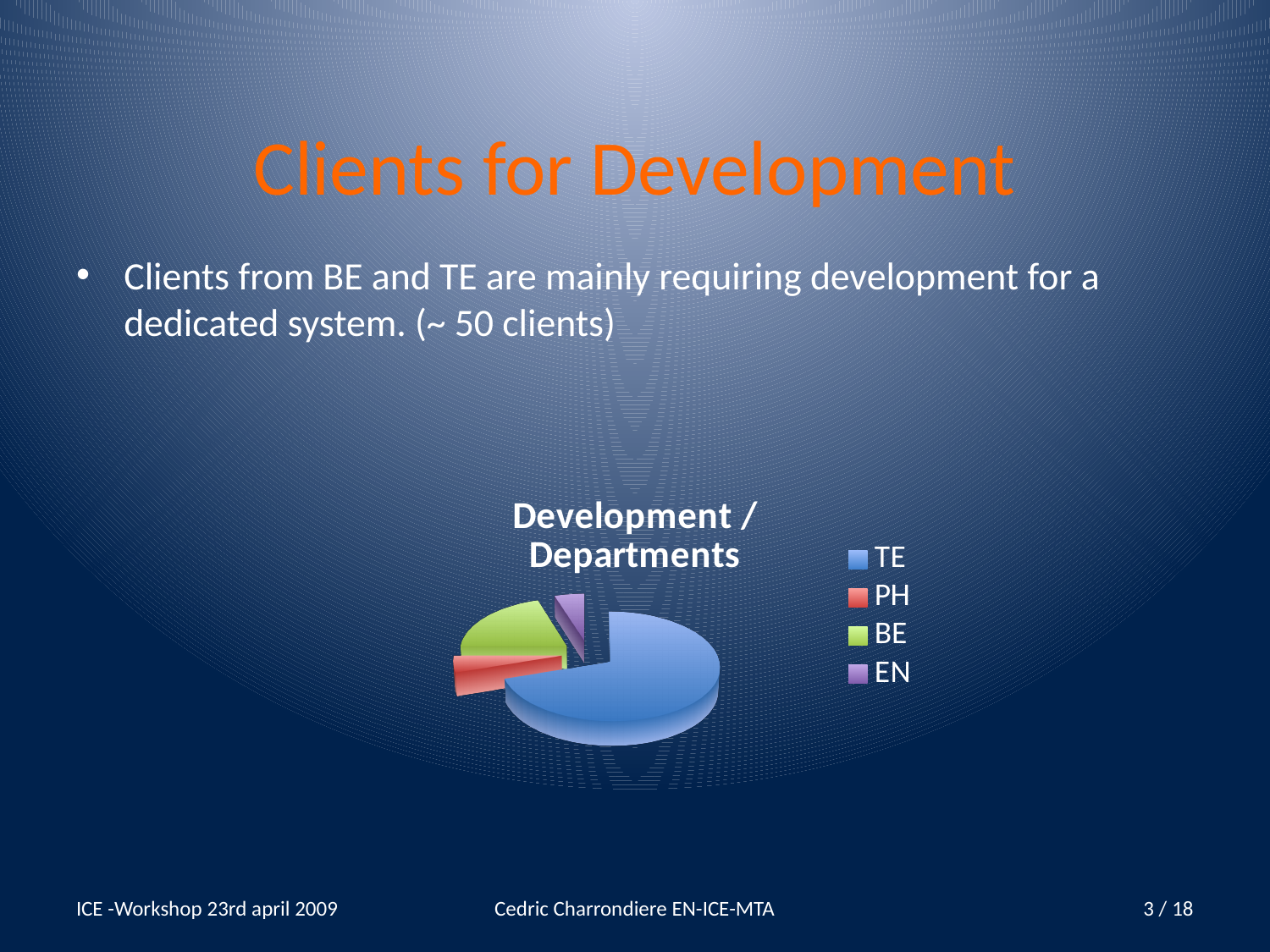
What is the title of the chart? Development / Departments How many entries does the chart legend list? 4 Which slice is larger, BE or PH? BE Which department has the largest slice of the pie? TE How many categories does the pie chart have? 4 What colour is the TE slice in the pie chart? blue What kind of chart is shown on the slide? pie chart Which slice is larger, TE or BE? TE